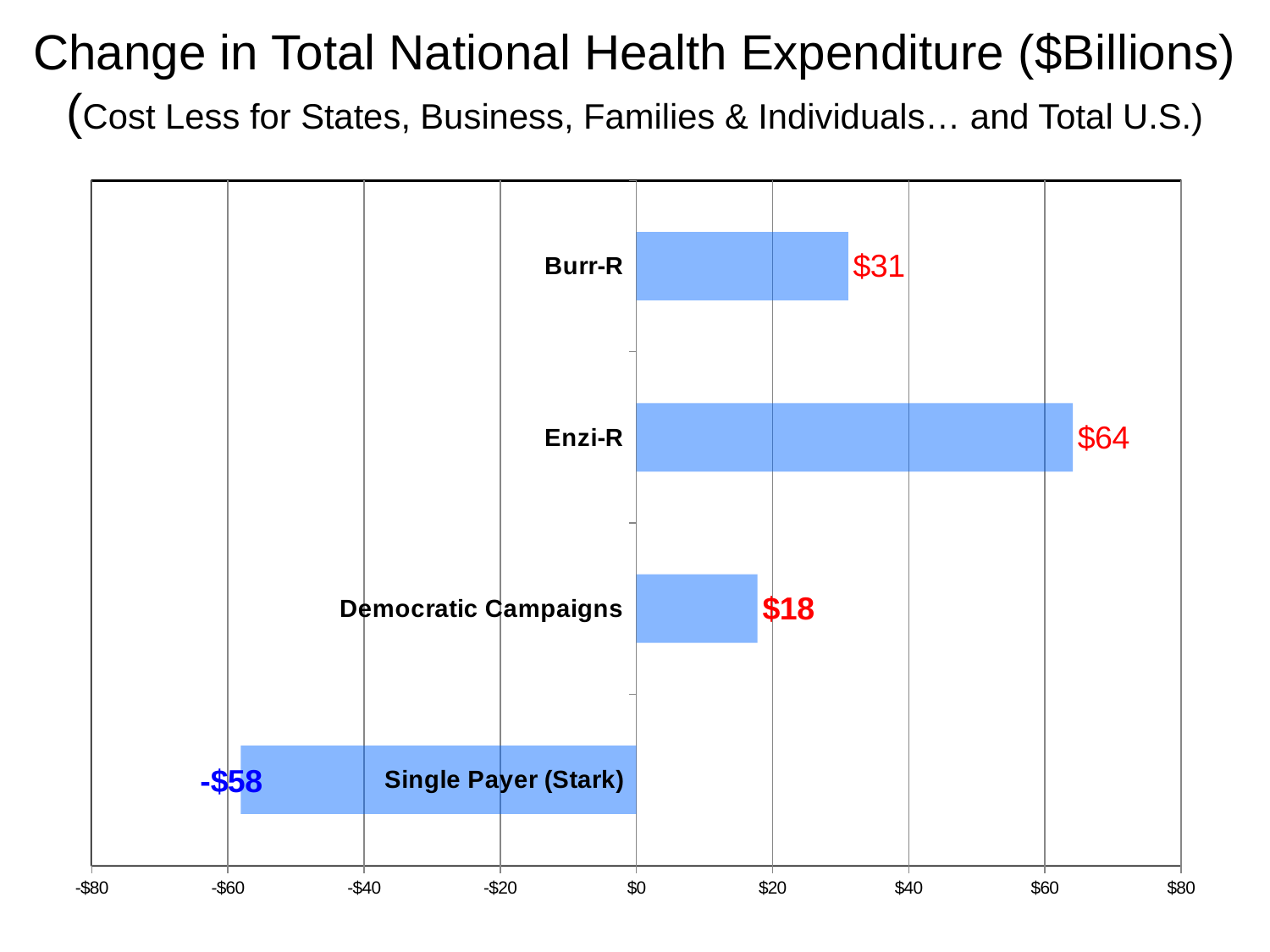
What is the value for Burr-R? $31 What kind of chart is shown on the slide? bar chart Which category has the lowest value? Single Payer (Stark) Which is larger, the value for Burr-R or the value for Democratic Campaigns? Burr-R What is the difference between the values for Enzi-R and Burr-R? $33 Which category has the highest value? Enzi-R What is the value for Single Payer (Stark)? -$58 How many categories are shown in the chart? 4 What is the value for Democratic Campaigns? $18 What is the title of the chart? Change in Total National Health Expenditure ($Billions) What is the value for Enzi-R? $64 Is the value for Enzi-R greater or less than $60? greater